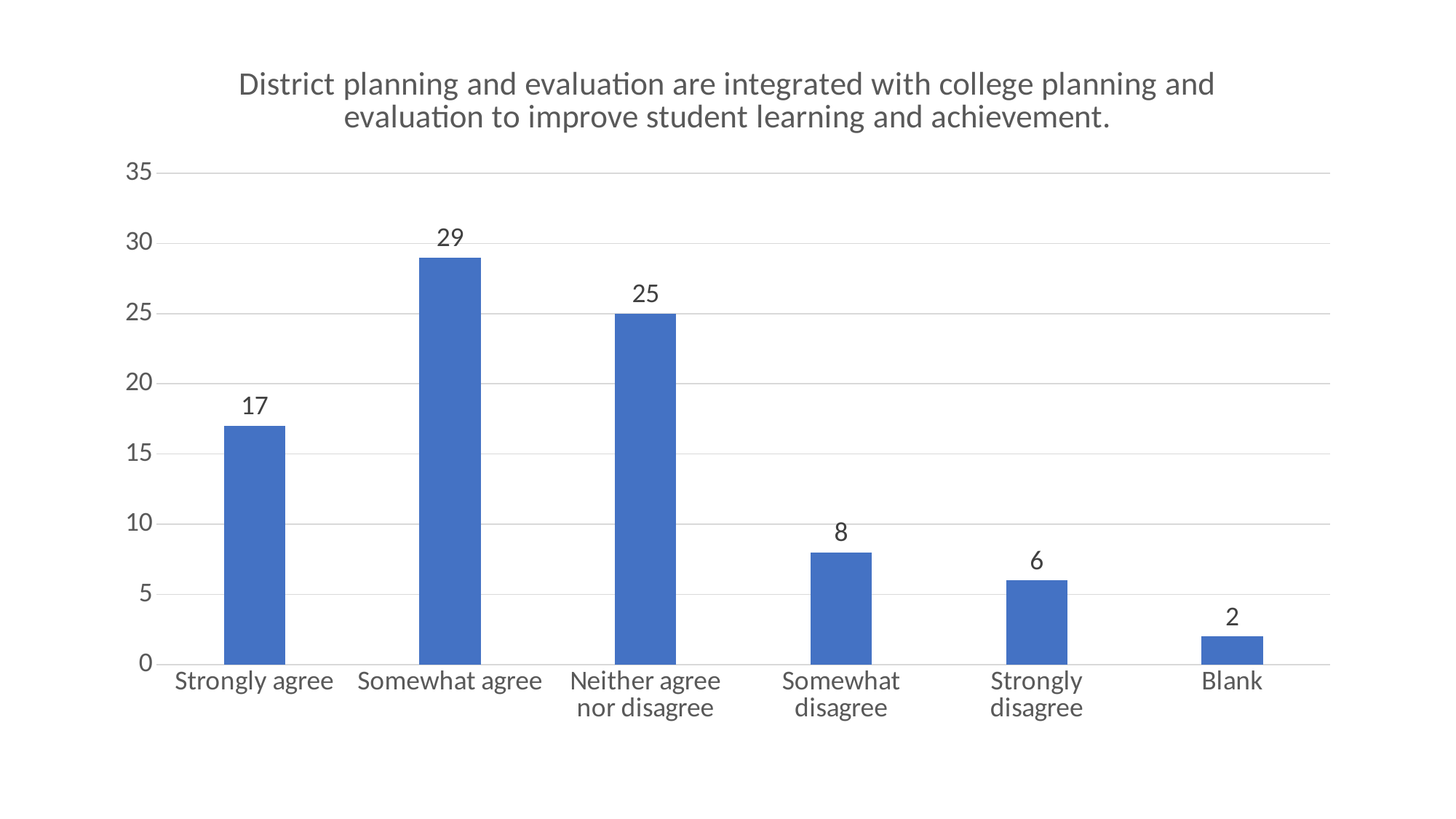
Which is larger, the value for Somewhat disagree or the value for Strongly disagree? Somewhat disagree What is the value for Neither agree nor disagree? 25 How many categories are shown on the x axis? 6 What is the title of the chart? District planning and evaluation are integrated with college planning and evaluation to improve student learning and achievement. Which category has the lowest value? Blank What is the value for Strongly agree? 17 What is the value for Blank? 2 Is the value for Neither agree nor disagree greater or less than 20? greater What kind of chart is this? bar chart What is the difference between the values for Somewhat agree and Strongly agree? 12 Which category has the highest value? Somewhat agree What is the difference between the values for Somewhat disagree and Strongly disagree? 2